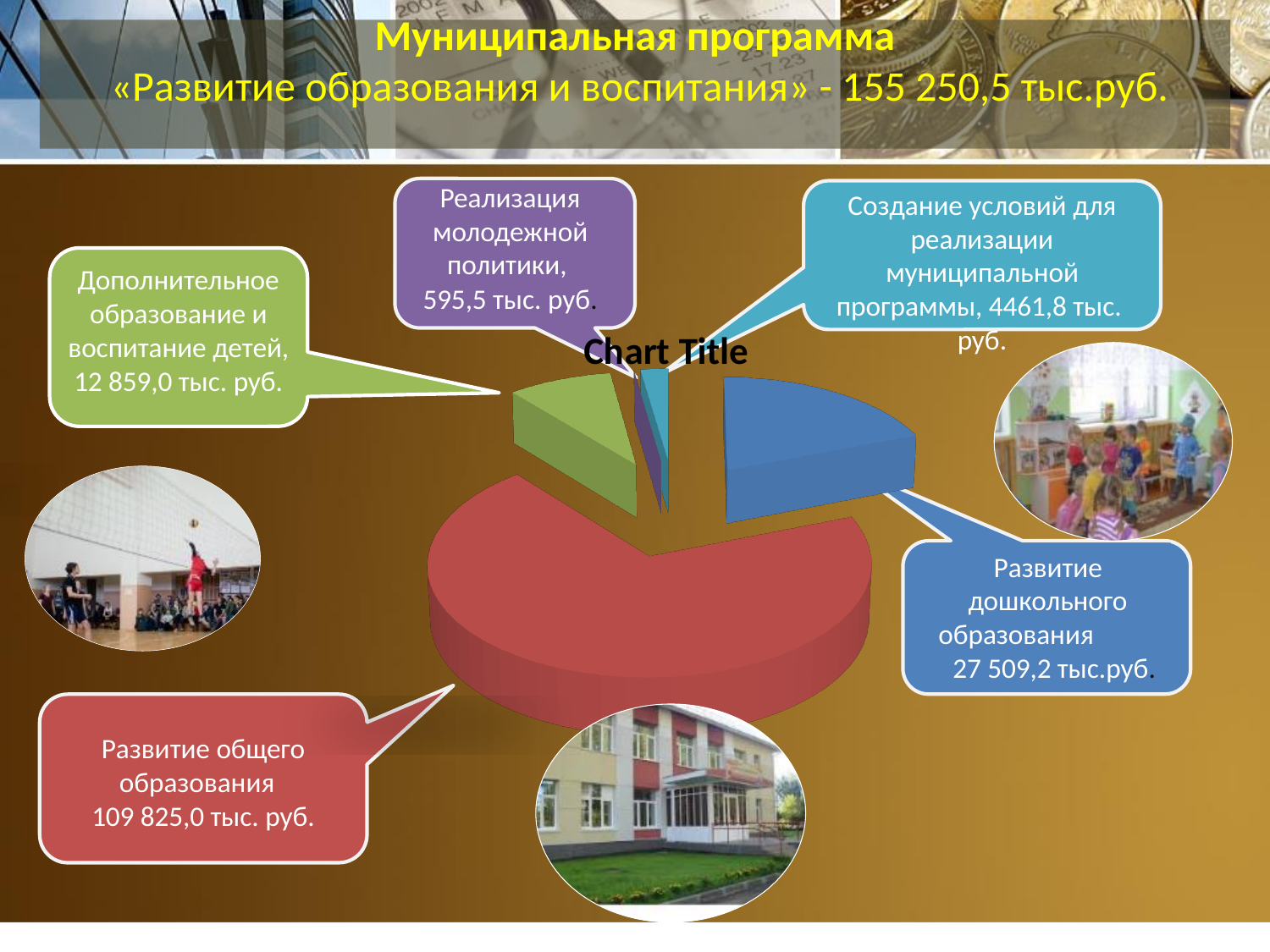
How many slices does the pie chart have? 5 What is the value for Дополнительное образование и воспитание детей? 12 859,0 тыс. руб. What is the value for Развитие общего образования? 109 825,0 тыс. руб. Which category has the largest slice of the pie chart? Развитие общего образования Which category has the smallest slice of the pie chart? Реализация молодежной политики What is the title printed above the pie chart? Chart Title Which is larger: Развитие дошкольного образования or Дополнительное образование и воспитание детей? Развитие дошкольного образования What colour is the slice for Развитие общего образования? Red What is the value for Развитие дошкольного образования? 27 509,2 тыс. руб. What is the difference between Развитие общего образования and Развитие дошкольного образования? 82 315,8 тыс. руб. What kind of chart is shown on the slide? Pie chart What is the value for Создание условий для реализации муниципальной программы? 4461,8 тыс. руб.